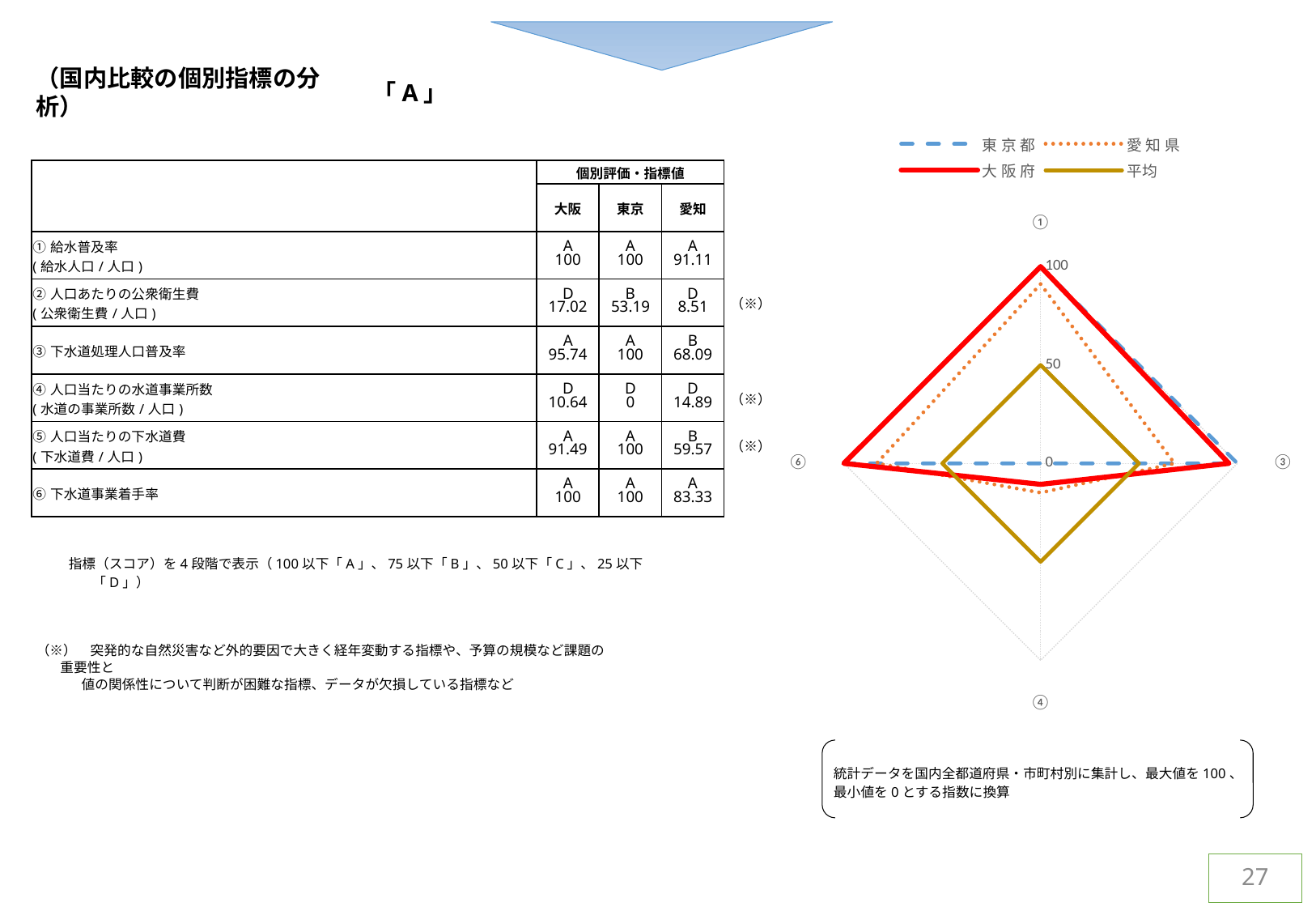
On the radar chart, is the value for 東京都 on axis ④ greater or less than 50? less On the radar chart, is the value for 愛知県 on axis ③ greater or less than 50? greater Which series are listed in the legend of the radar chart? 東京都, 愛知県, 大阪府, 平均 What kind of chart is shown on the right side of the slide? radar chart On the radar chart, is the value for 大阪府 on axis ④ greater or less than 50? less How many axes (categories) does the radar chart have? 4 On the radar chart, which is larger on axis ①: 大阪府 or 平均? 大阪府 On the radar chart, which series has the lowest value on axis ⑥? 平均 How many series does the legend of the radar chart list? 4 Which series on the radar chart is drawn as a solid red line? 大阪府 On the radar chart, which is larger on axis ④: 平均 or 東京都? 平均